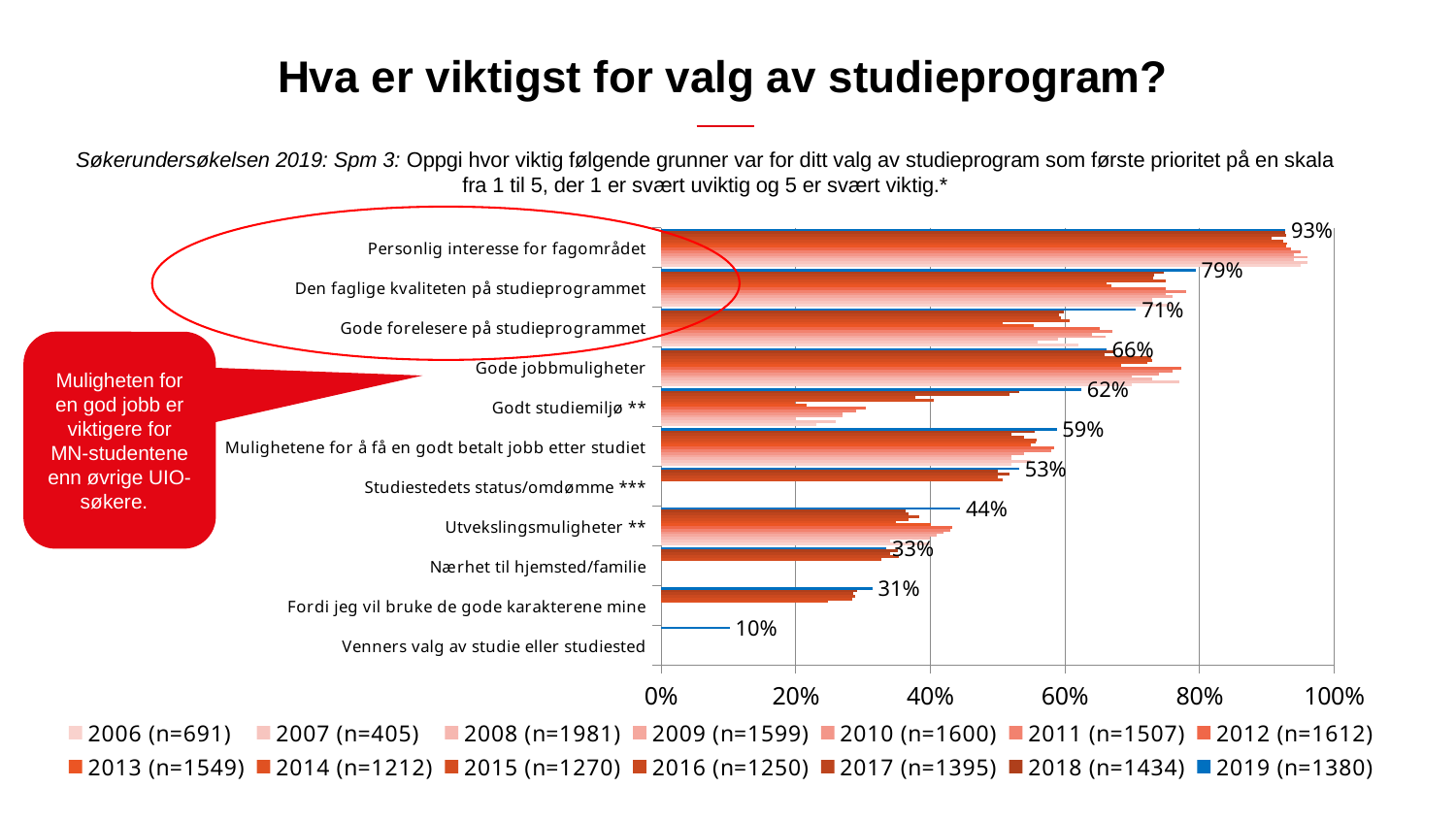
Which category has the lowest 2019 value? Venners valg av studie eller studiested What is the 2019 value for 'Gode jobbmuligheter'? 66% How many categories are shown on the chart? 11 What is the 2019 value for 'Personlig interesse for fagområdet'? 93% What is the sample size (n) for the 2019 series in the legend? 1380 Which has a higher 2019 value: 'Godt studiemiljø **' or 'Studiestedets status/omdømme ***'? Godt studiemiljø ** What is the difference between the 2019 values for 'Personlig interesse for fagområdet' and 'Den faglige kvaliteten på studieprogrammet'? 14 percentage points How many series does the legend list? 14 What is the 2019 value for 'Utvekslingsmuligheter **'? 44% What is the 2019 value for 'Venners valg av studie eller studiested'? 10% Which category has the highest 2019 value? Personlig interesse for fagområdet What type of chart is shown on the slide? bar chart